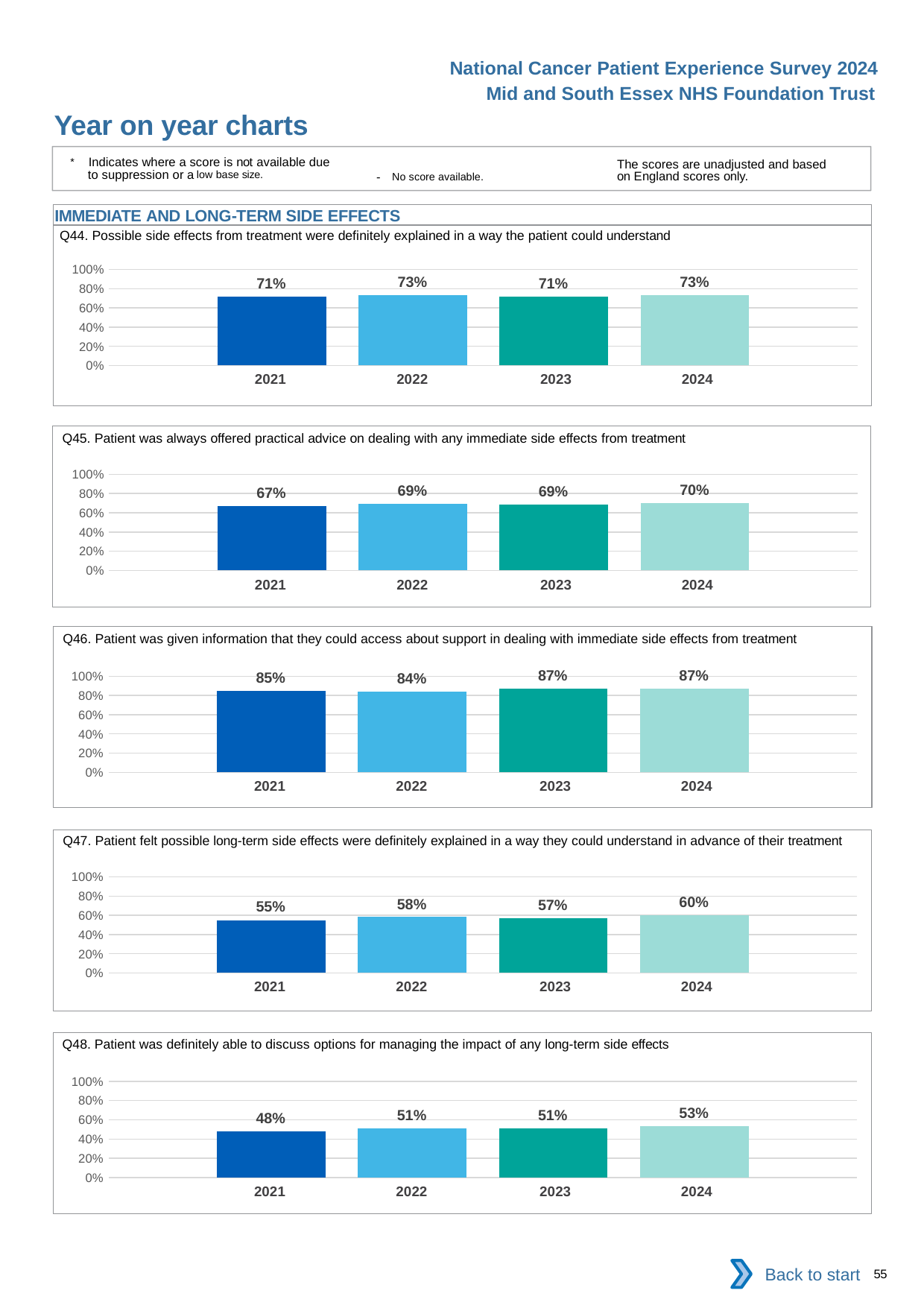
In the Q46 chart, which year has the lowest value? 2022 In the Q45 chart, which year has the lowest value? 2021 In the Q48 chart, do the values generally rise or fall from 2021 to 2024? rise How many years are shown on the x axis of the Q47 chart? 4 In the Q47 chart, which is larger, the value for 2021 or the value for 2024? 2024 What kind of chart is the Q48 chart? bar chart In the Q45 chart, which year has the highest value? 2024 In the Q44 chart, what is the value for 2022? 73% In the Q46 chart, what is the difference between the 2023 value and the 2022 value? 3% In the Q47 chart, what is the value for 2023? 57% In the Q48 chart, is the value for 2021 greater or less than 60%? less What is the section heading above the Q44 chart? IMMEDIATE AND LONG-TERM SIDE EFFECTS